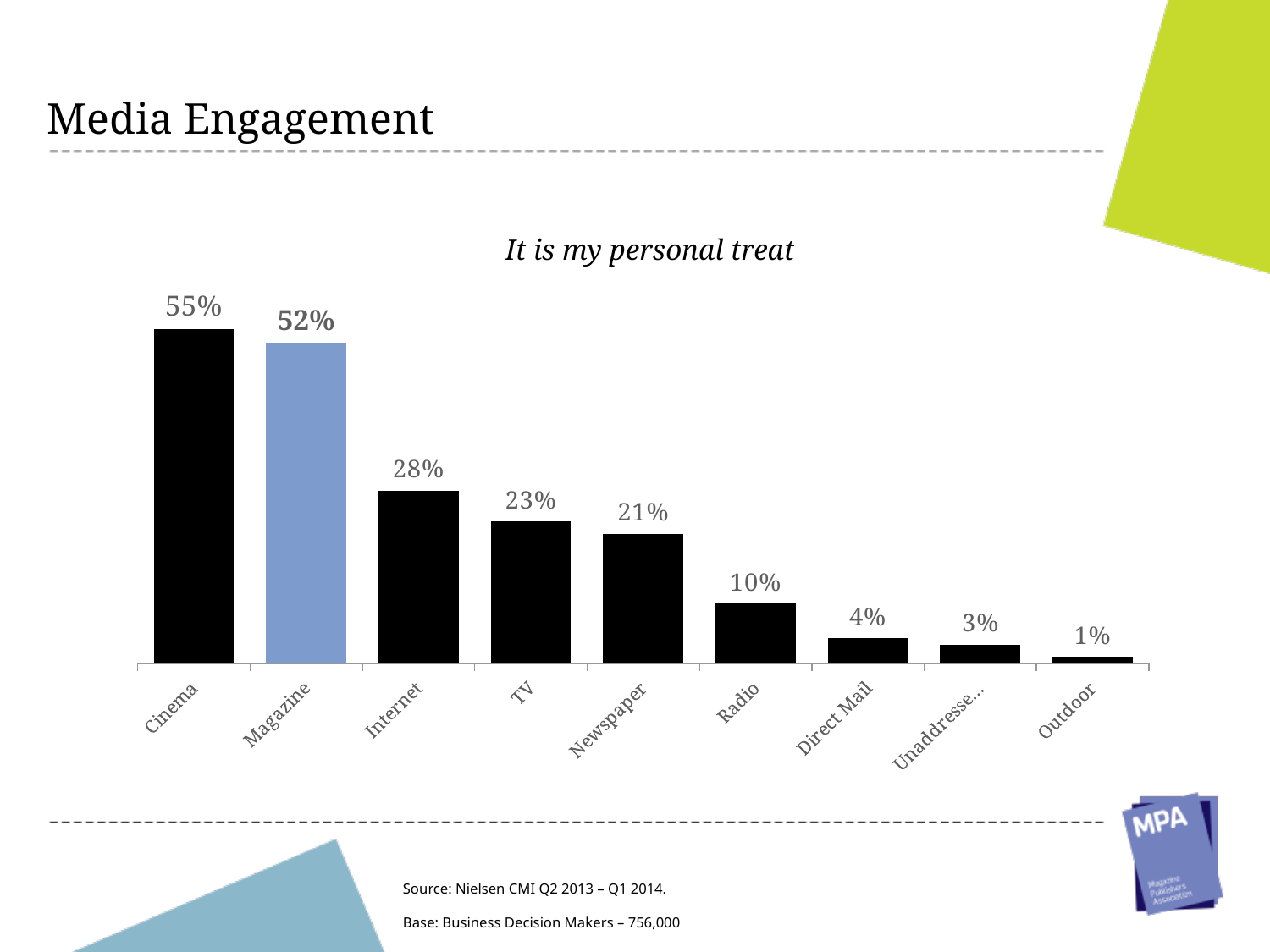
Which category has the highest value? Cinema What is the value for Magazine? 52% How many categories are shown on the chart? 9 Which is larger, the value for TV or the value for Newspaper? TV What is the value for Radio? 10% What is the value for Internet? 28% What is the title of the chart? It is my personal treat Which category has the lowest value? Outdoor What is the difference between the values for Internet and TV? 5% What is the value for Cinema? 55% What is the difference between the values for Cinema and Magazine? 3% What kind of chart is shown on the slide? Bar chart